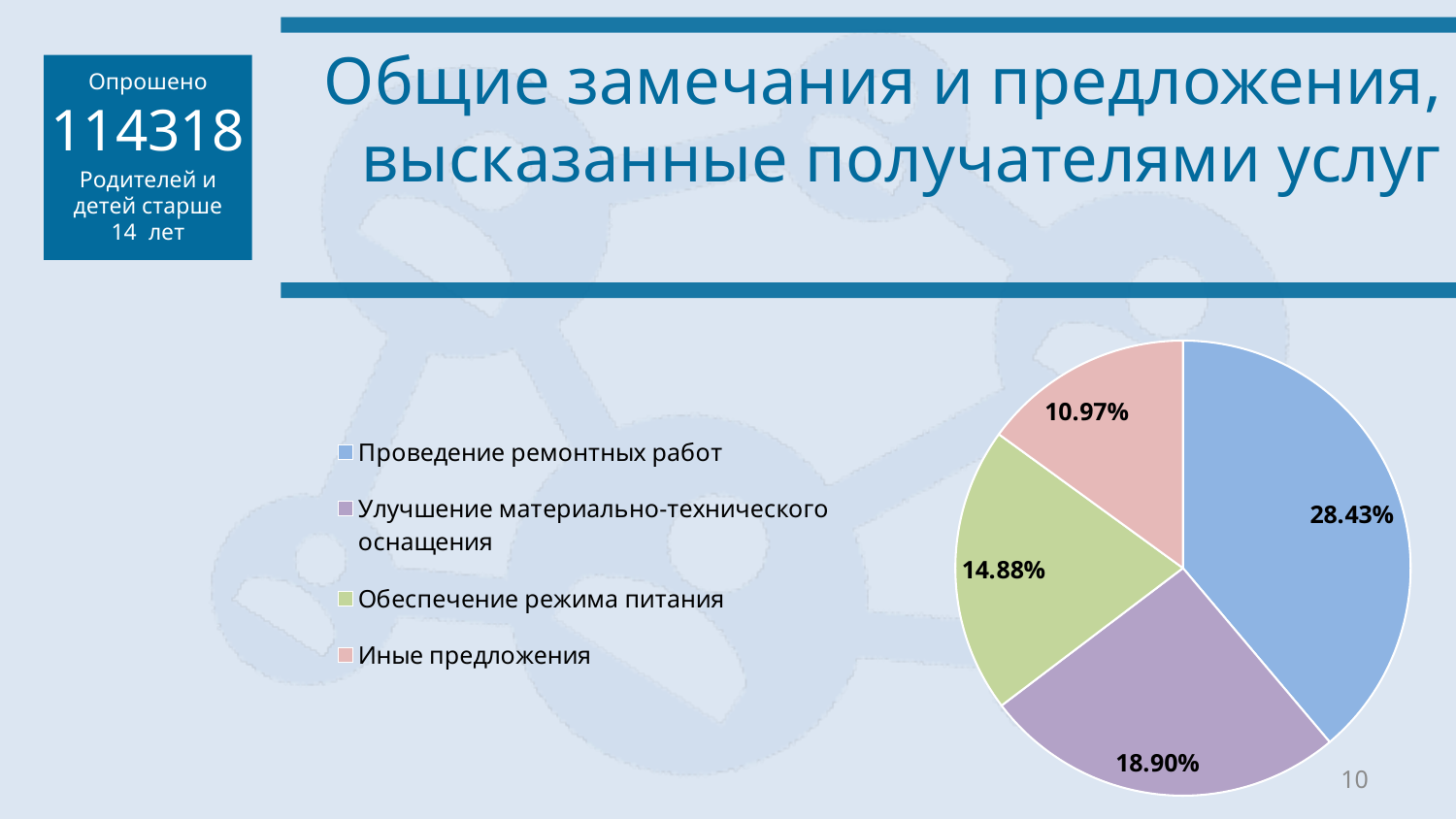
Which category has the smallest slice of the pie chart? Иные предложения What is the value shown for "Проведение ремонтных работ"? 28.43% What kind of chart is shown on the slide? Pie chart Which is larger: the value for "Обеспечение режима питания" or the value for "Иные предложения"? Обеспечение режима питания Which category has the largest slice of the pie chart? Проведение ремонтных работ What is the difference between the values for "Проведение ремонтных работ" and "Улучшение материально-технического оснащения"? 9.53% What is the value shown for "Обеспечение режима питания"? 14.88% What colour is the slice for "Обеспечение режима питания"? Green How many slices does the pie chart have? 4 How many entries does the legend of the pie chart list? 4 What is the value shown for "Иные предложения"? 10.97% What is the value shown for "Улучшение материально-технического оснащения"? 18.90%